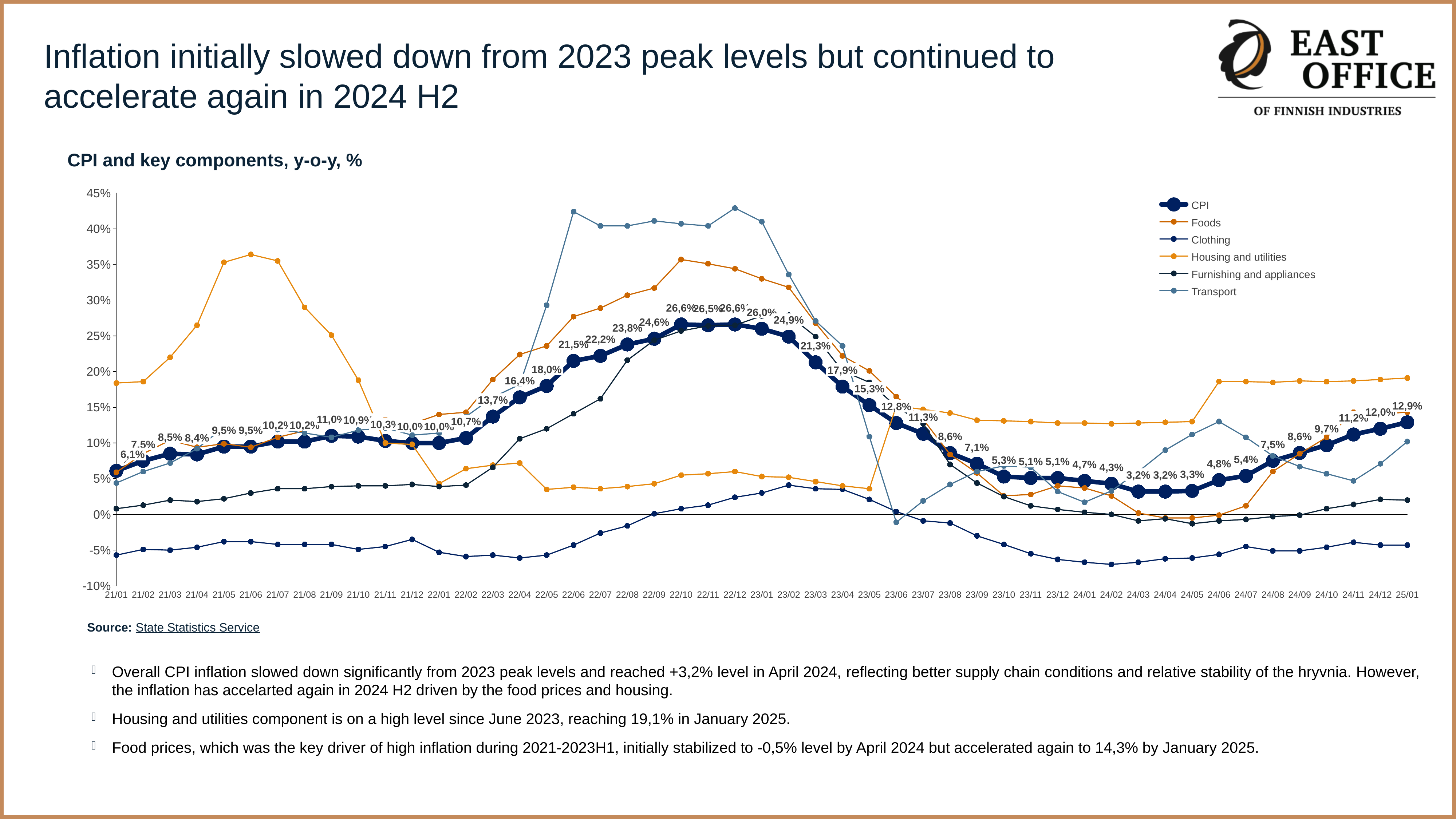
What is the CPI value for 25/01? 12,9% What is the CPI value for 21/01? 6,1% How many series does the legend list? 6 What is the CPI value for 23/03? 21,3% By how many percentage points does the CPI value for 25/01 exceed the CPI value for 24/01? 8,2 percentage points What kind of chart is shown on the slide? Line chart Does the CPI line rise or fall from 24/04 to 25/01? Rise Is the Transport value for 22/06 greater or less than 40%? greater Which series is drawn with the thick dark blue line? CPI Which is larger, the CPI value for 22/03 or the CPI value for 23/06? 22/03 What is the lowest CPI value labelled on the chart? 3,2% What is the highest CPI value labelled on the chart? 26,6%